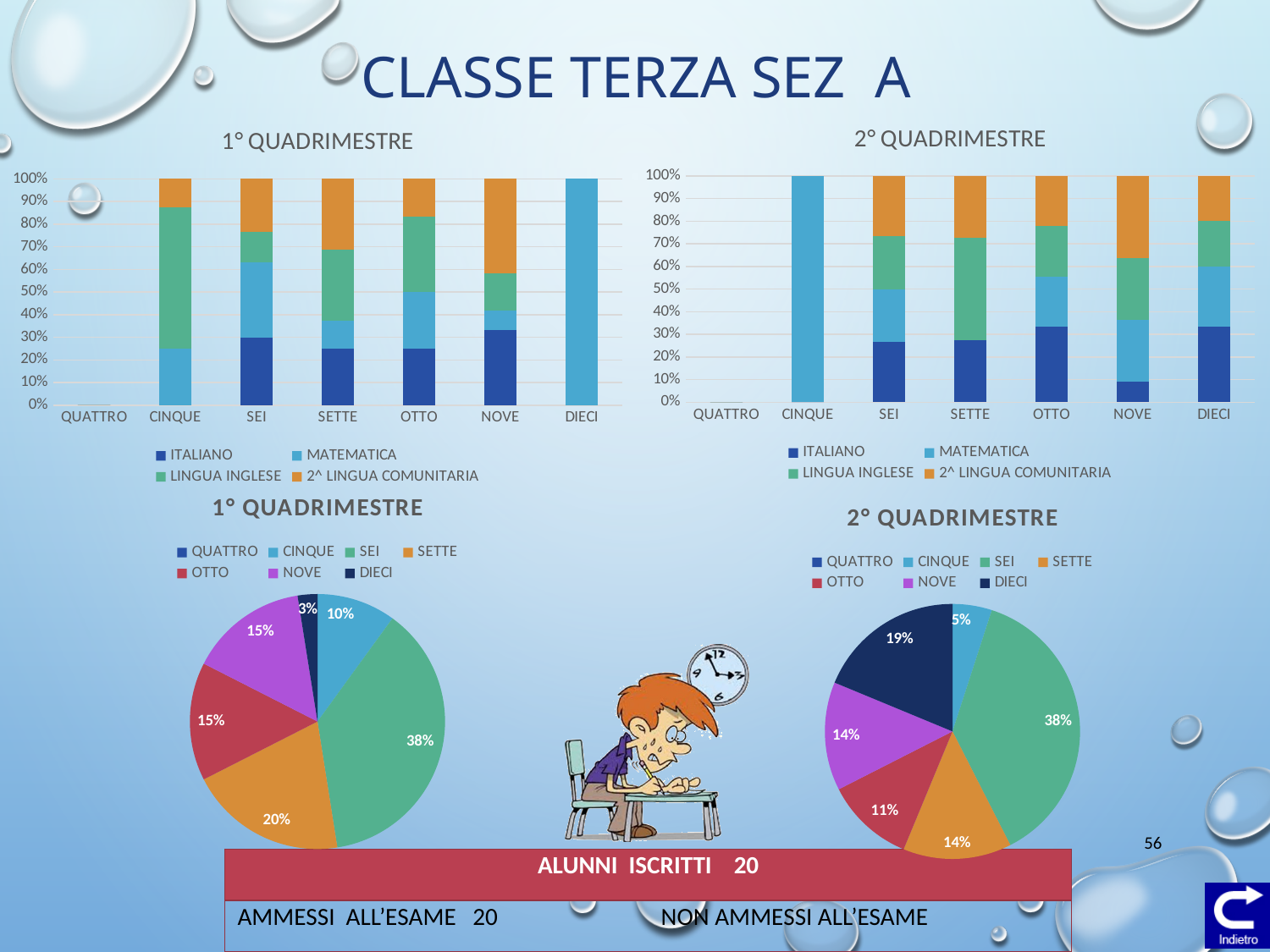
In the bottom-right pie chart titled 2° QUADRIMESTRE, what share does DIECI have? 19% In the bottom-left pie chart titled 1° QUADRIMESTRE, what share does SEI have? 38% In the bottom-left pie chart titled 1° QUADRIMESTRE, what share does SETTE have? 20% In the bottom-left pie chart titled 1° QUADRIMESTRE, which labelled category has the smallest slice? DIECI In the top-right bar chart titled 2° QUADRIMESTRE, is the ITALIANO value for NOVE greater or less than 20%? less What kind of chart is the top-left chart titled 1° QUADRIMESTRE? Bar chart In the bottom-right pie chart titled 2° QUADRIMESTRE, what is the difference in percentage points between the SEI slice and the DIECI slice? 19 In the bottom-left pie chart titled 1° QUADRIMESTRE, which is larger, the OTTO slice or the CINQUE slice? OTTO In the top-left bar chart titled 1° QUADRIMESTRE, how many categories are shown on the x axis? 7 In the bottom-right pie chart titled 2° QUADRIMESTRE, which category has the largest slice? SEI In the top-right bar chart titled 2° QUADRIMESTRE, how many series does the legend list? 4